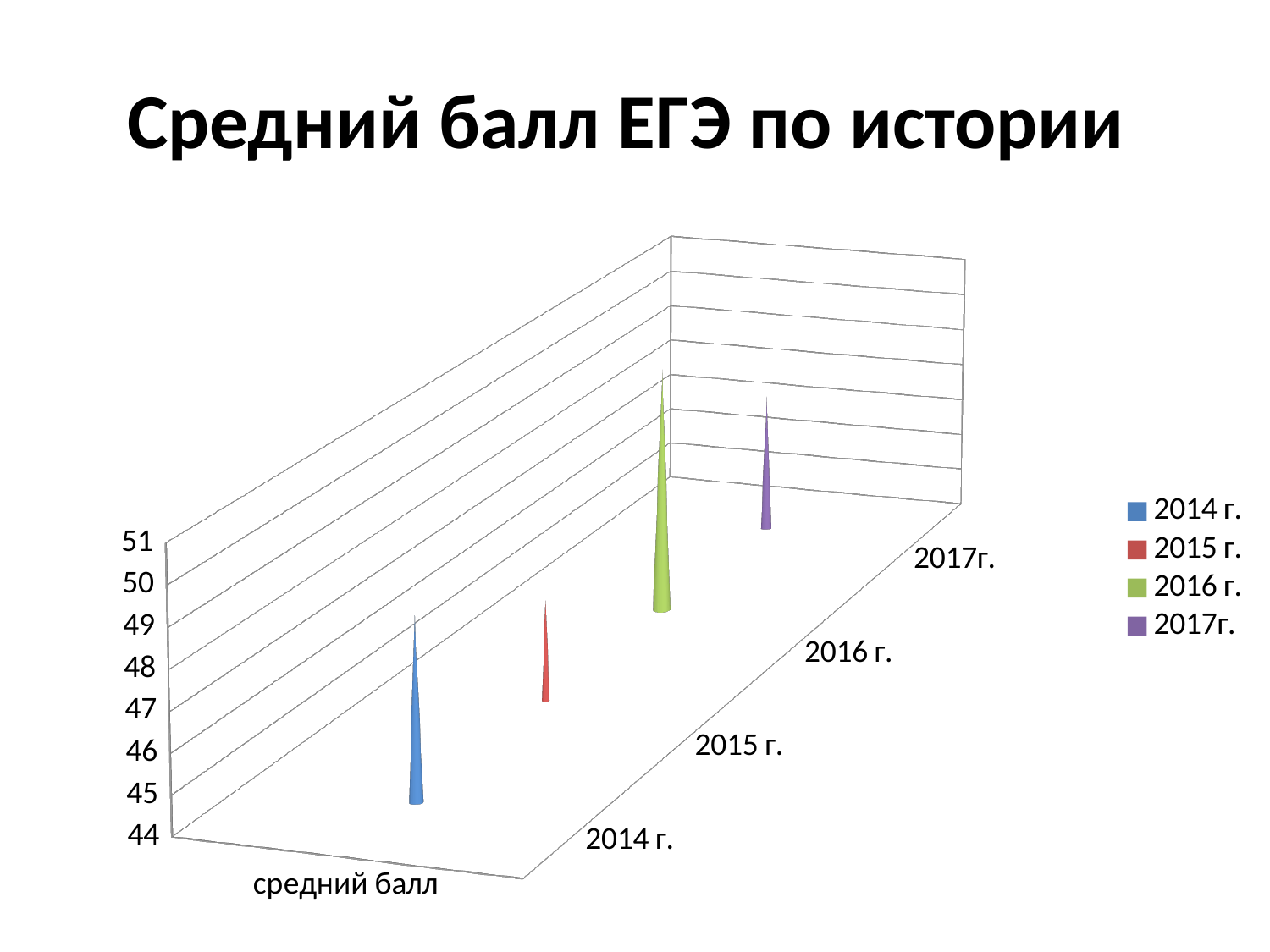
What is the lowest value shown on the vertical axis? 44 What is the title of the chart? Средний балл ЕГЭ по истории How many categories are shown on the category axis? 1 Which is larger, the value for 2016 г. or the value for 2014 г.? 2016 г. Which series is shown in green in the legend? 2016 г. What is the label of the single category on the category axis? средний балл Which is larger, the value for 2016 г. or the value for 2015 г.? 2016 г. What kind of chart is shown on the slide? bar chart How many series does the legend list? 4 Which year has the highest average score in the chart? 2016 г.